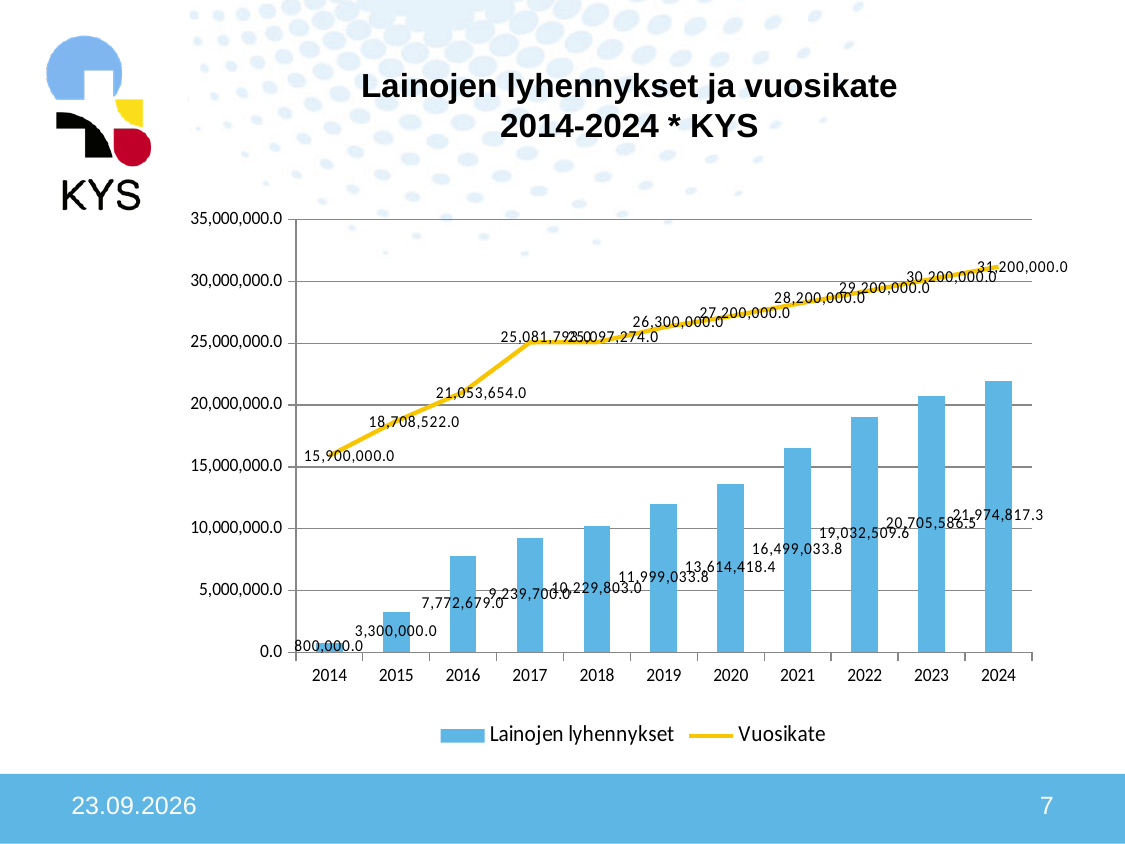
What is the value of Lainojen lyhennykset for 2024? 21,974,817.3 How many series does the legend list? 2 In 2020, which is larger: Lainojen lyhennykset or Vuosikate? Vuosikate How many years are shown on the x axis? 11 What is the value of Lainojen lyhennykset for 2019? 11,999,033.8 What kind of chart is shown on the slide? A combined bar and line chart Do the Lainojen lyhennykset values rise or fall from 2014 to 2024? Rise What is the value of Vuosikate for 2024? 31,200,000.0 What is the difference between Lainojen lyhennykset in 2024 and 2023? 1,269,230.8 Which year has the highest Lainojen lyhennykset value? 2024 What is the difference between Vuosikate in 2023 and 2022? 1,000,000.0 Which year has the lowest Vuosikate value? 2014